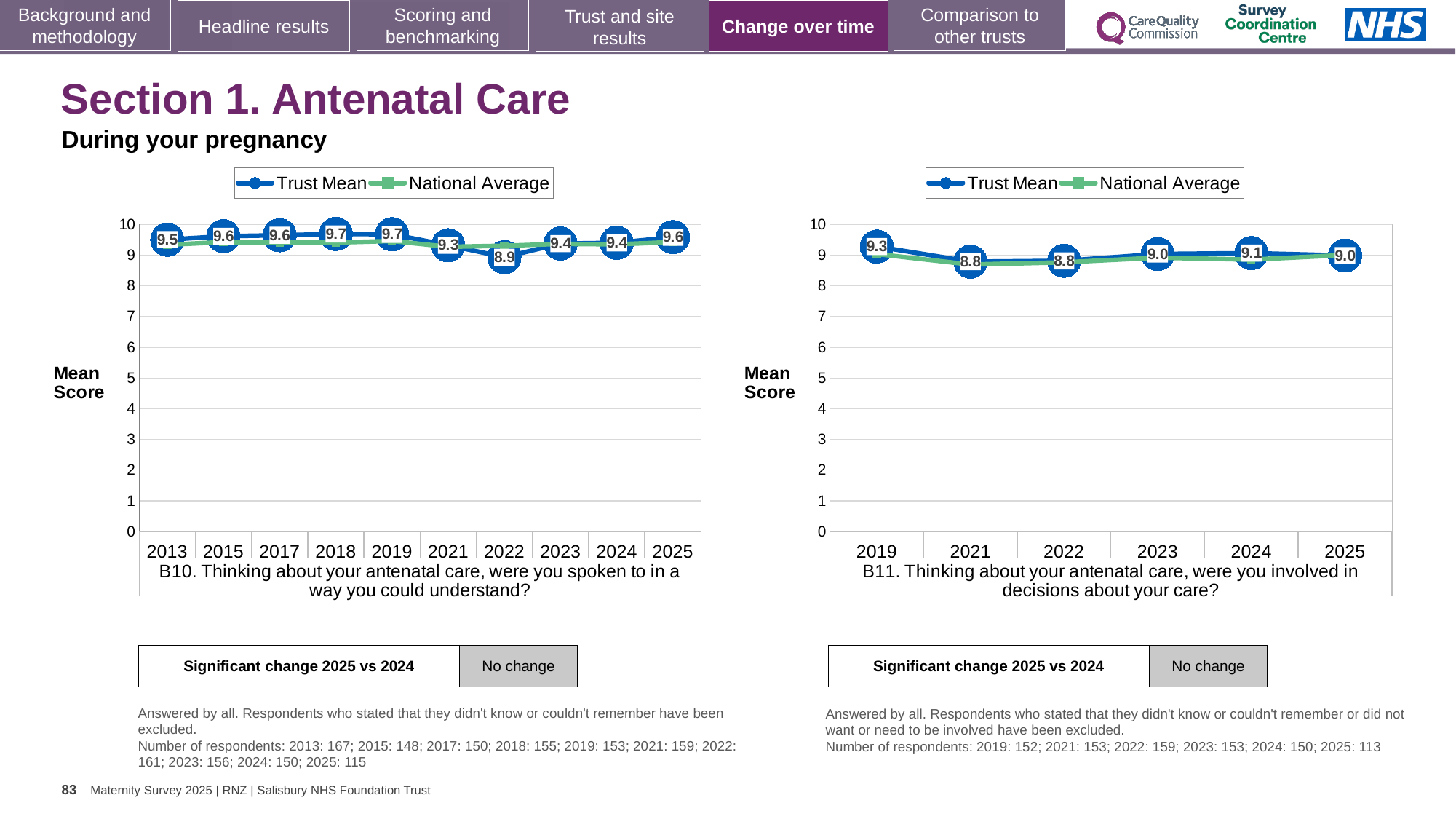
In the B11 chart on the right, how many series does the legend list? 2 In the B10 chart on the left, how many years are plotted along the x axis? 10 In the B11 chart on the right, what is the difference between the Trust Mean scores for 2019 and 2021? 0.5 In the B11 chart on the right, what is the Trust Mean score for 2019? 9.3 In the B11 chart on the right, what colour is the National Average line? green In the B10 chart on the left, which year has the lowest Trust Mean score? 2022 In the B10 chart on the left, what is the difference between the Trust Mean scores for 2025 and 2022? 0.7 In the B11 chart on the right, is the Trust Mean score for 2024 higher or lower than for 2021? higher What type of chart is used for the B10 question on the left? line chart In the B10 chart on the left, what is the Trust Mean score for 2022? 8.9 In the B11 chart on the right, which year has the highest Trust Mean score? 2019 In the B10 chart on the left, what is the Trust Mean score for 2025? 9.6